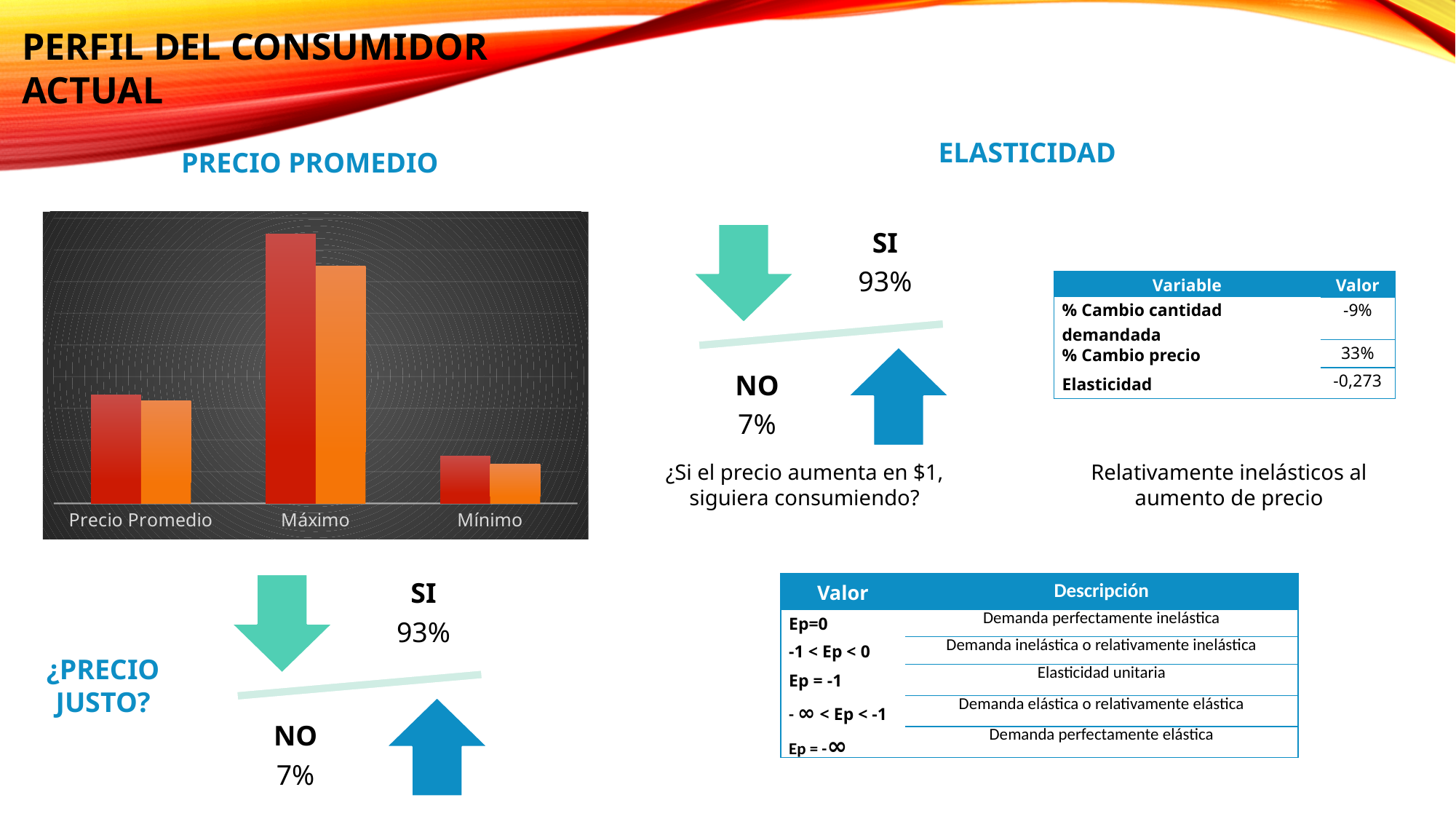
How many bars are drawn for each category in the PRECIO PROMEDIO bar chart? 2 How many categories are shown on the x axis of the PRECIO PROMEDIO bar chart? 3 Which category has the tallest bars in the PRECIO PROMEDIO bar chart? Máximo What kind of chart is shown under the heading PRECIO PROMEDIO? Bar chart What are the three category labels on the x axis of the PRECIO PROMEDIO bar chart, from left to right? Precio Promedio, Máximo, Mínimo Does the PRECIO PROMEDIO bar chart display a legend? No What two colours are used for the bars in the PRECIO PROMEDIO bar chart? Red and orange In the PRECIO PROMEDIO bar chart, is the red bar for Precio Promedio taller or shorter than the red bar for Máximo? Shorter Which category has the shortest bars in the PRECIO PROMEDIO bar chart? Mínimo In the PRECIO PROMEDIO bar chart, which bar is taller for the Máximo category, the red one or the orange one? The red one In the PRECIO PROMEDIO bar chart, is the orange bar for Mínimo taller or shorter than the orange bar for Precio Promedio? Shorter